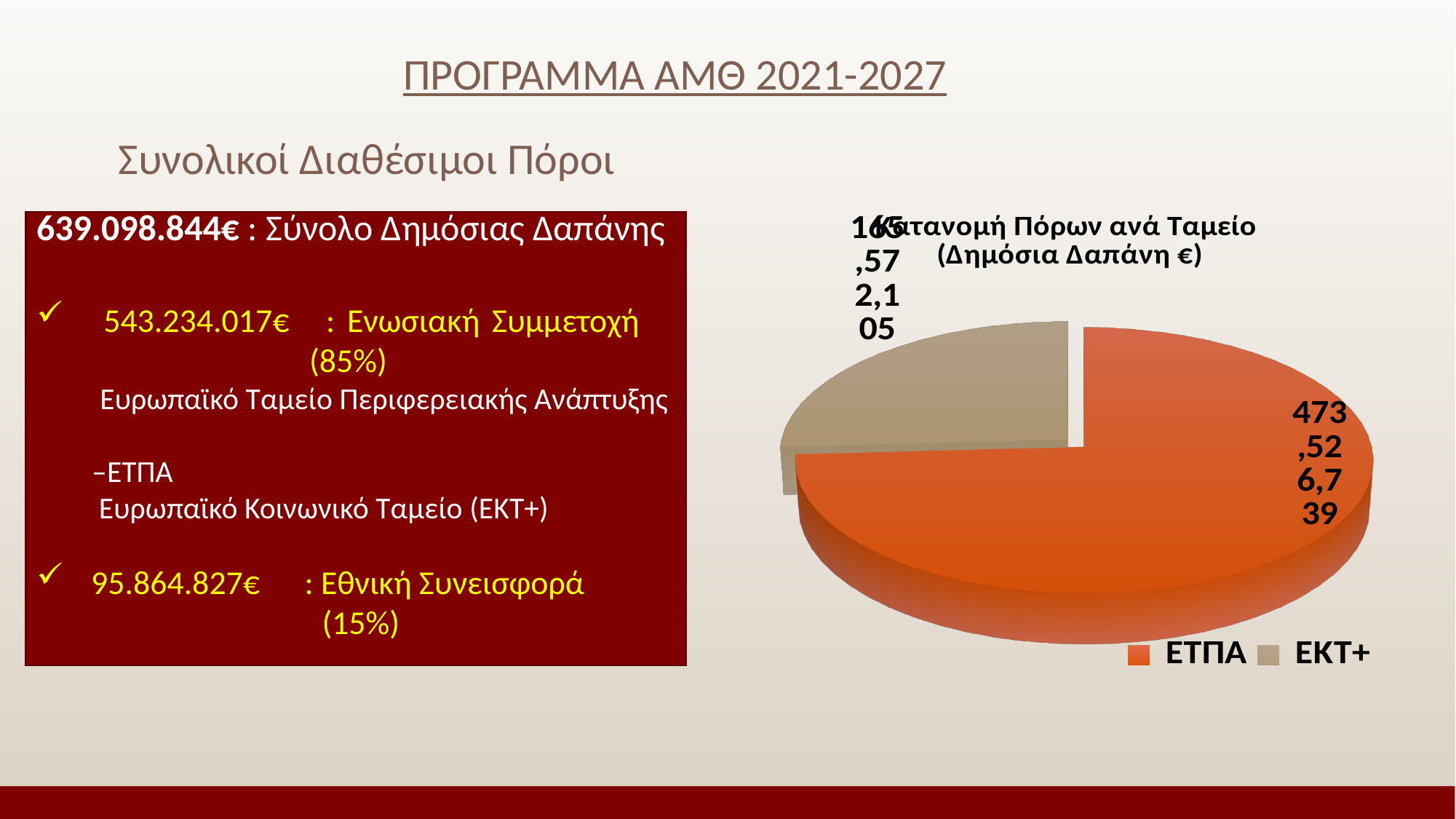
Which fund has the smallest slice in the pie chart? ΕΚΤ+ What value is shown for ΕΤΠΑ in the pie chart? 473,526,739 How many slices does the pie chart have? 2 Which fund has the largest slice in the pie chart? ΕΤΠΑ How many entries does the legend of the pie chart list? 2 What is the title of the pie chart? Κατανομή Πόρων ανά Ταμείο (Δημόσια Δαπάνη €) Does the ΕΤΠΑ slice account for more or less than half of the pie? more What kind of chart is shown on the slide? pie chart Which slice is larger in the pie chart, ΕΤΠΑ or ΕΚΤ+? ΕΤΠΑ What colour is the ΕΤΠΑ slice in the pie chart? orange